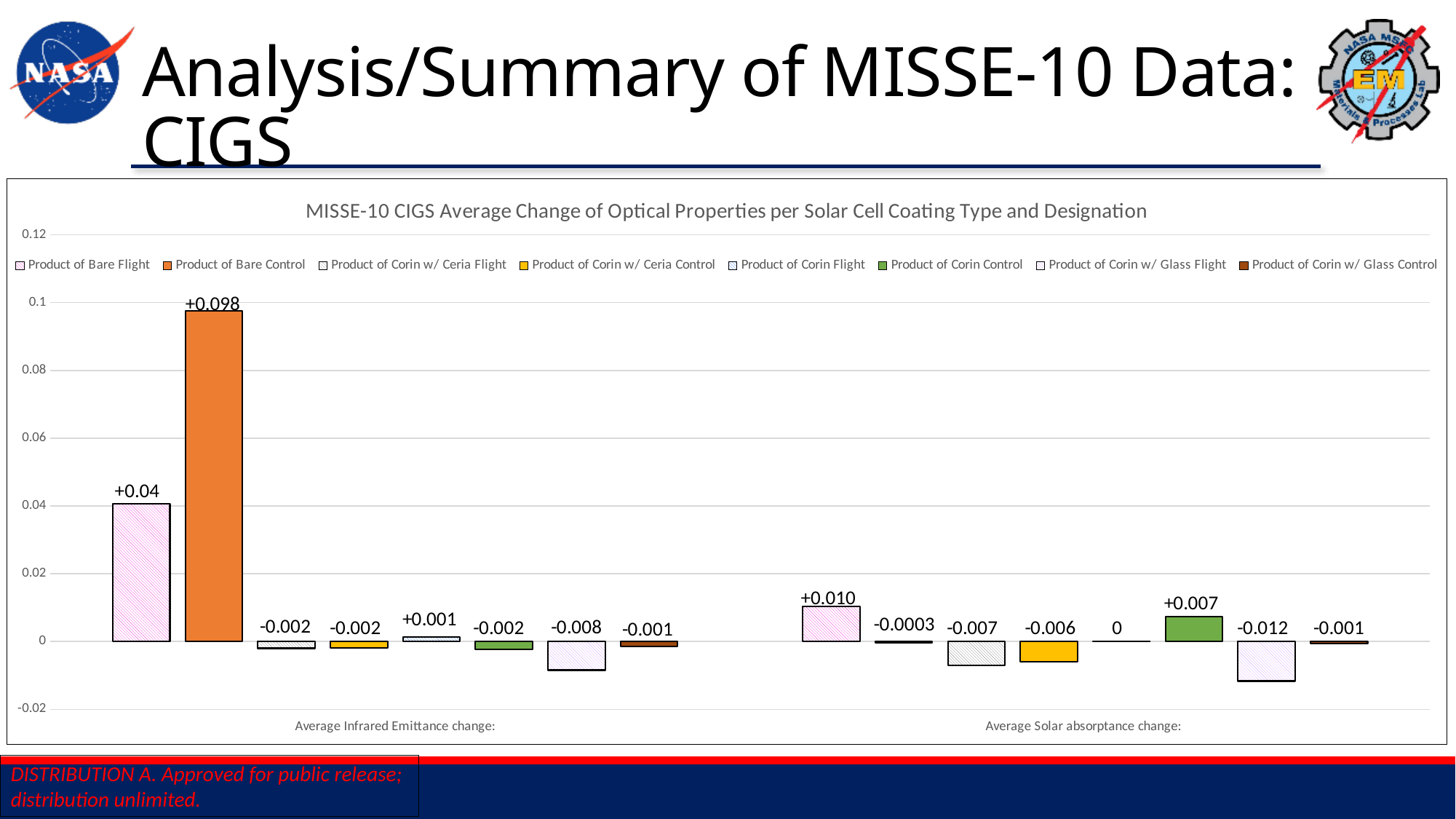
How many series does the legend list? 8 What is the value of Product of Corin Flight for Average Solar absorptance change? 0 Which is larger for Average Solar absorptance change: Product of Bare Flight or Product of Corin Control? Product of Bare Flight What is the value of Product of Corin w/ Glass Flight for Average Solar absorptance change? -0.012 Which series has the highest value for Average Infrared Emittance change? Product of Bare Control How many categories are shown on the x axis? 2 What is the difference between Product of Bare Control and Product of Bare Flight for Average Infrared Emittance change? 0.058 What is the value of Product of Bare Control for Average Infrared Emittance change? +0.098 What type of chart is shown on the slide? Bar chart Which series has the lowest value for Average Solar absorptance change? Product of Corin w/ Glass Flight What is the value of Product of Bare Flight for Average Infrared Emittance change? +0.04 What is the value of Product of Corin Control for Average Solar absorptance change? +0.007